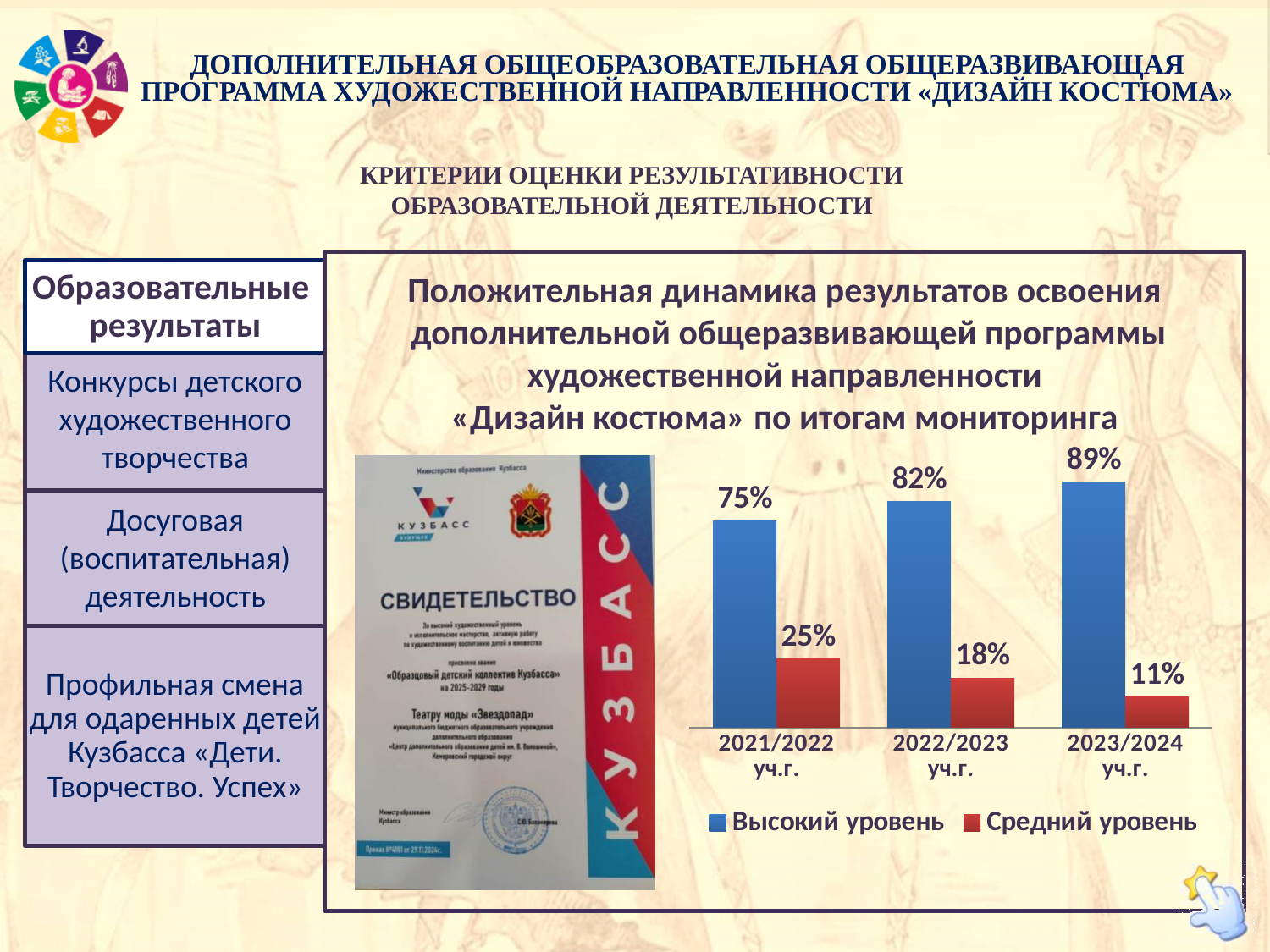
In which academic year is the Средний уровень value lowest? 2023/2024 уч.г. How many academic years are shown on the x axis of the chart? 3 In which academic year is the Высокий уровень value highest? 2023/2024 уч.г. What is the difference between Высокий уровень and Средний уровень in 2022/2023 уч.г.? 64% Does the Средний уровень value rise or fall from 2021/2022 уч.г. to 2023/2024 уч.г.? Fall What is the value for Высокий уровень in 2022/2023 уч.г.? 82% What is the value for Средний уровень in 2023/2024 уч.г.? 11% What is the difference between the Высокий уровень values for 2023/2024 уч.г. and 2021/2022 уч.г.? 14% How many series does the chart legend list? 2 What is the value for Высокий уровень in 2021/2022 уч.г.? 75% Which is larger in 2021/2022 уч.г.: Высокий уровень or Средний уровень? Высокий уровень What type of chart is shown on the slide? Bar chart